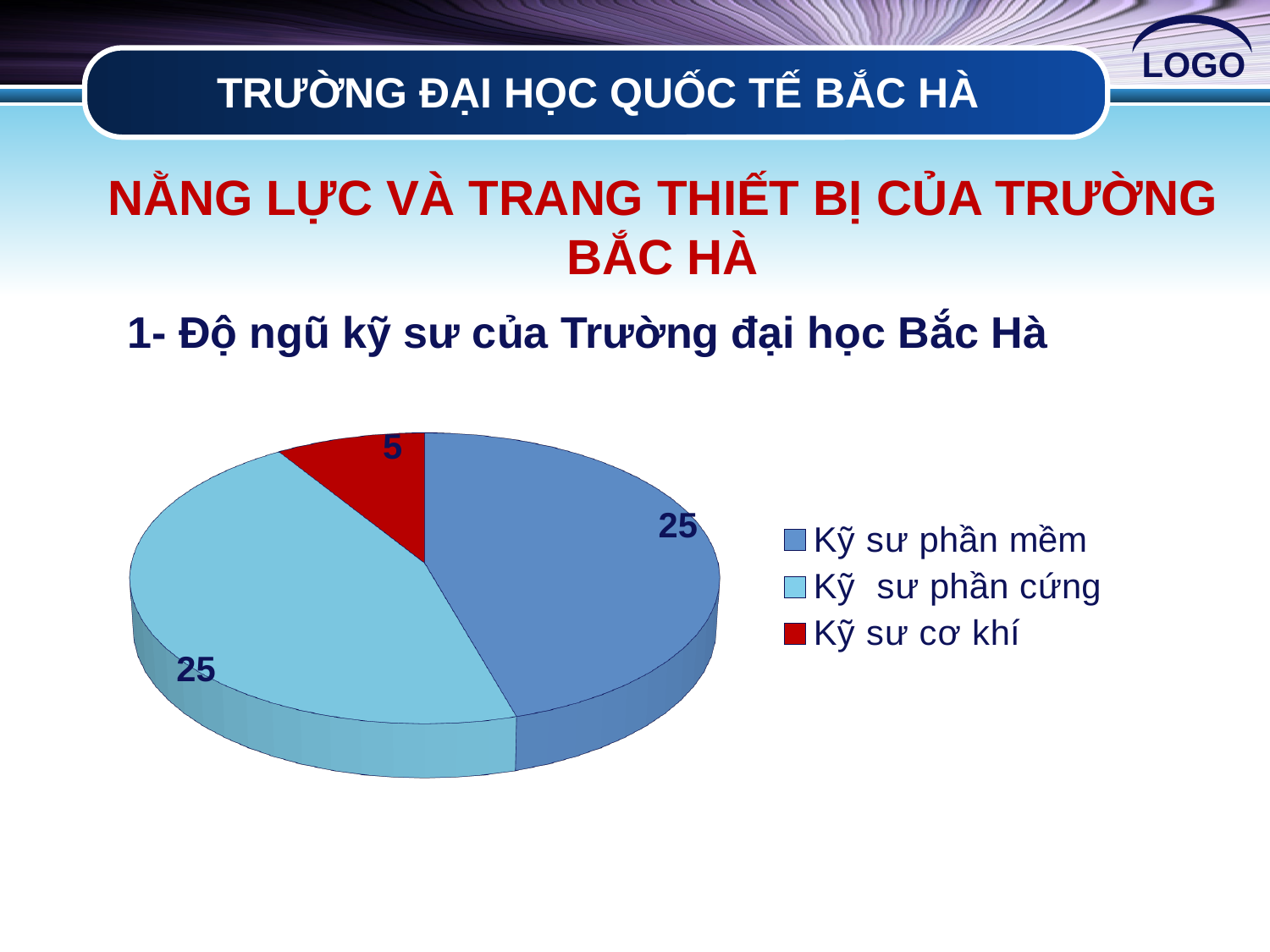
What value is shown for Kỹ sư phần cứng in the pie chart? 25 What is the total of all the values shown in the pie chart? 55 What value is shown for Kỹ sư cơ khí in the pie chart? 5 What value is shown for Kỹ sư phần mềm in the pie chart? 25 Which is larger, the value for Kỹ sư phần mềm or the value for Kỹ sư cơ khí? Kỹ sư phần mềm How many entries does the chart legend list? 3 How many slices does the pie chart have? 3 Which category has the smallest slice in the pie chart? Kỹ sư cơ khí What share of the pie does Kỹ sư cơ khí represent, rounded to the nearest whole percent? 9% What colour is the Kỹ sư cơ khí slice in the pie chart? Red What kind of chart is shown on the slide? Pie chart What is the difference between the value for Kỹ sư phần cứng and the value for Kỹ sư cơ khí? 20